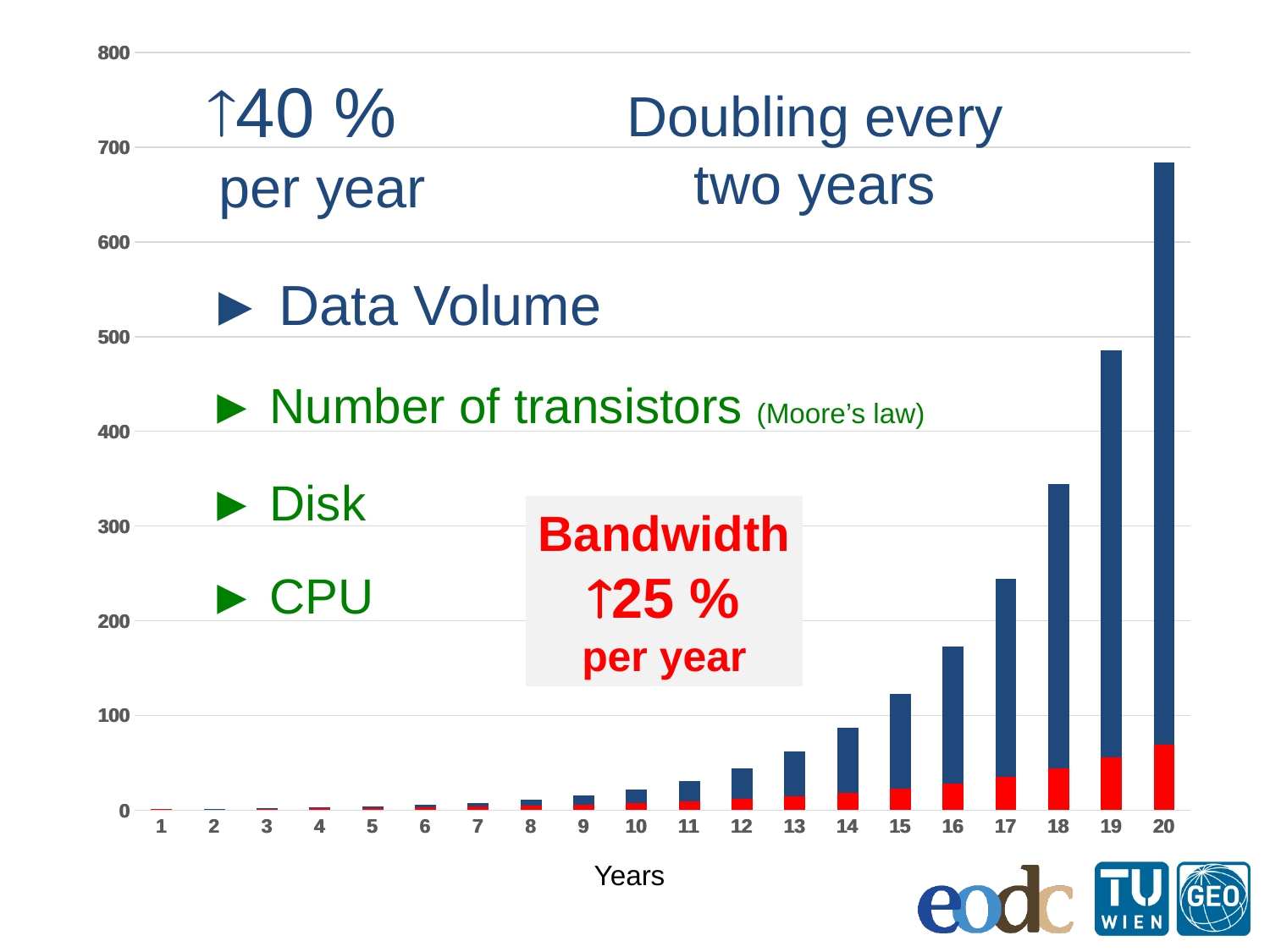
Which year has the shortest bar? 1 What is the title of the x axis? Years Do the bar heights rise or fall as the years increase from 1 to 20? rise Which bar is taller, year 17 or year 18? 18 What is the highest value shown on the y axis? 800 What kind of chart is shown on the slide? bar chart Is the total bar height for year 10 greater or less than 100? less Is the total bar height for year 19 greater or less than 500? less Is the total bar height for year 18 greater or less than 300? greater How many years (categories) are plotted along the x axis? 20 Which year has the tallest bar? 20